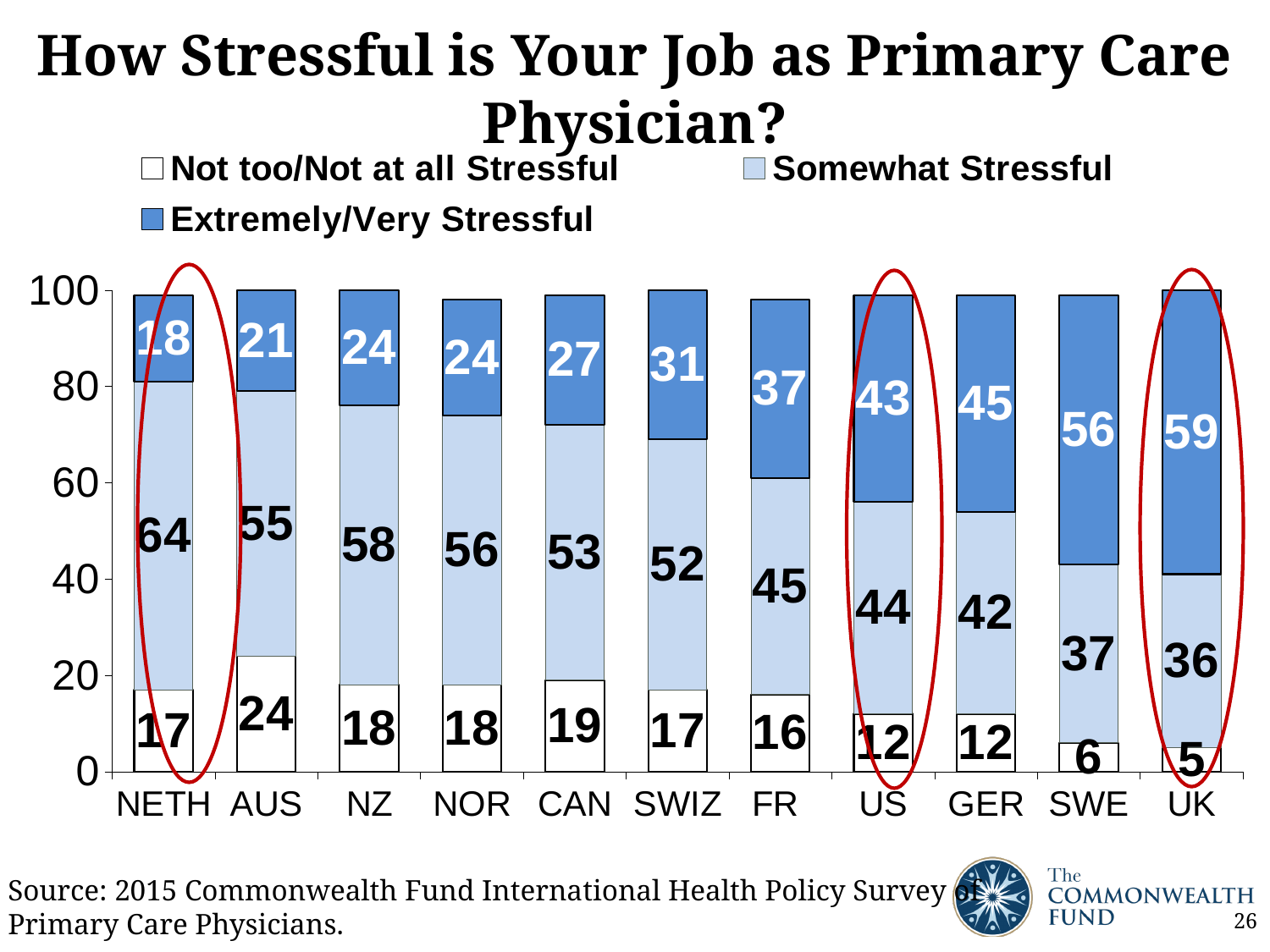
What is the difference between the Extremely/Very Stressful values for the US and NETH? 25 What is the Extremely/Very Stressful value for the UK? 59 Which is larger, the Somewhat Stressful value for AUS or for FR? AUS Which series is shown in the darkest blue colour? Extremely/Very Stressful What is the Somewhat Stressful value for NETH? 64 How many series does the legend list? 3 What type of chart is shown on the slide? Stacked bar chart Which country has the highest Extremely/Very Stressful value? UK Which country has the lowest Not too/Not at all Stressful value? UK How many countries are shown on the x axis? 11 What is the Not too/Not at all Stressful value for SWE? 6 What is the total of the stacked bar for GER? 99